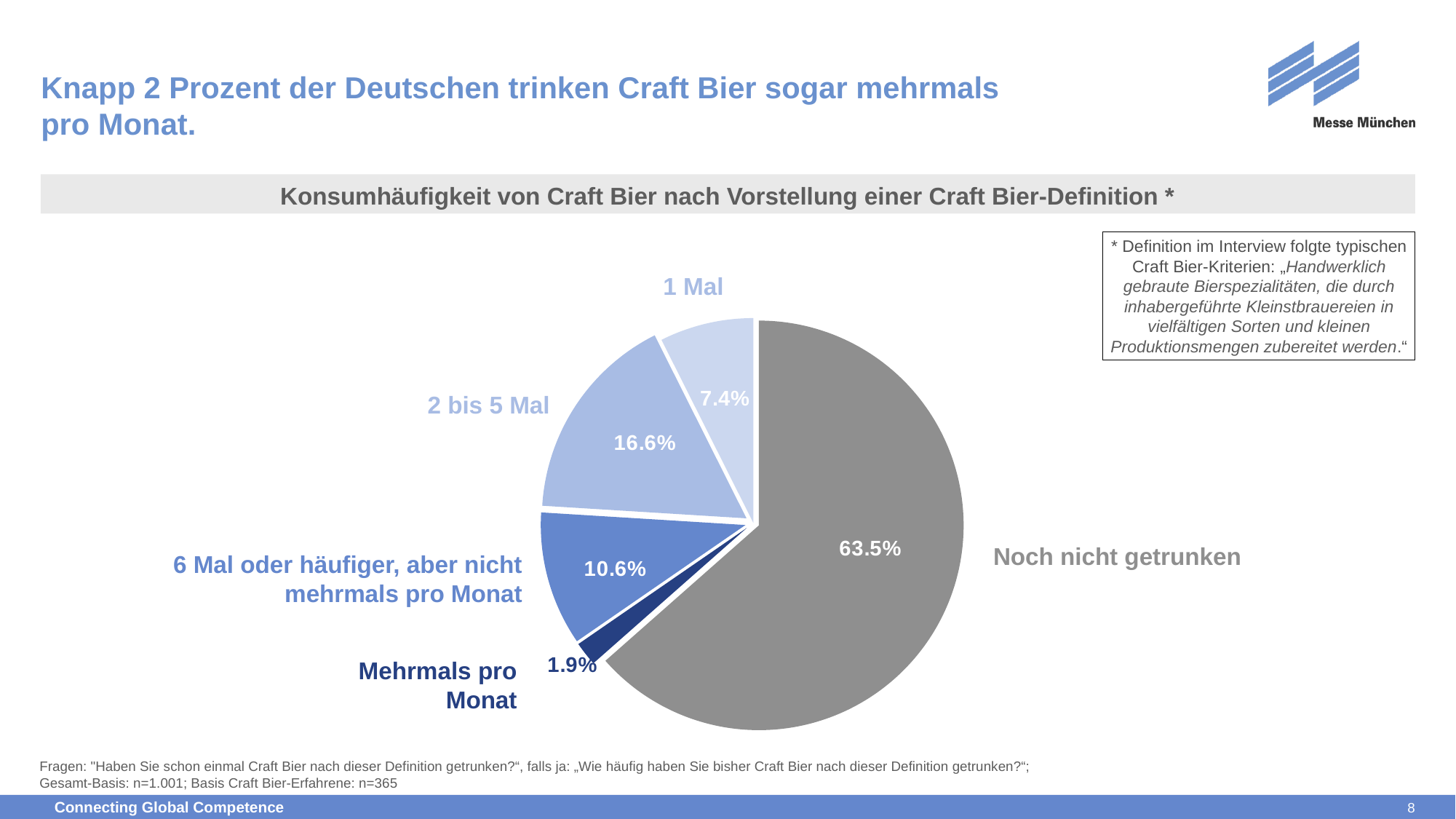
How many slices does the pie chart have? 5 Which category has the largest slice of the pie? Noch nicht getrunken What is the difference between the values for "2 bis 5 Mal" and "1 Mal"? 9.2% What is the value for "Noch nicht getrunken"? 63.5% Which is larger, the value for "2 bis 5 Mal" or the value for "6 Mal oder häufiger, aber nicht mehrmals pro Monat"? 2 bis 5 Mal What is the title of the chart? Konsumhäufigkeit von Craft Bier nach Vorstellung einer Craft Bier-Definition * What is the value for "6 Mal oder häufiger, aber nicht mehrmals pro Monat"? 10.6% Which category has the smallest slice of the pie? Mehrmals pro Monat What kind of chart is shown on the slide? pie chart What is the value for "1 Mal"? 7.4% What is the value for "2 bis 5 Mal"? 16.6% What is the value for "Mehrmals pro Monat"? 1.9%